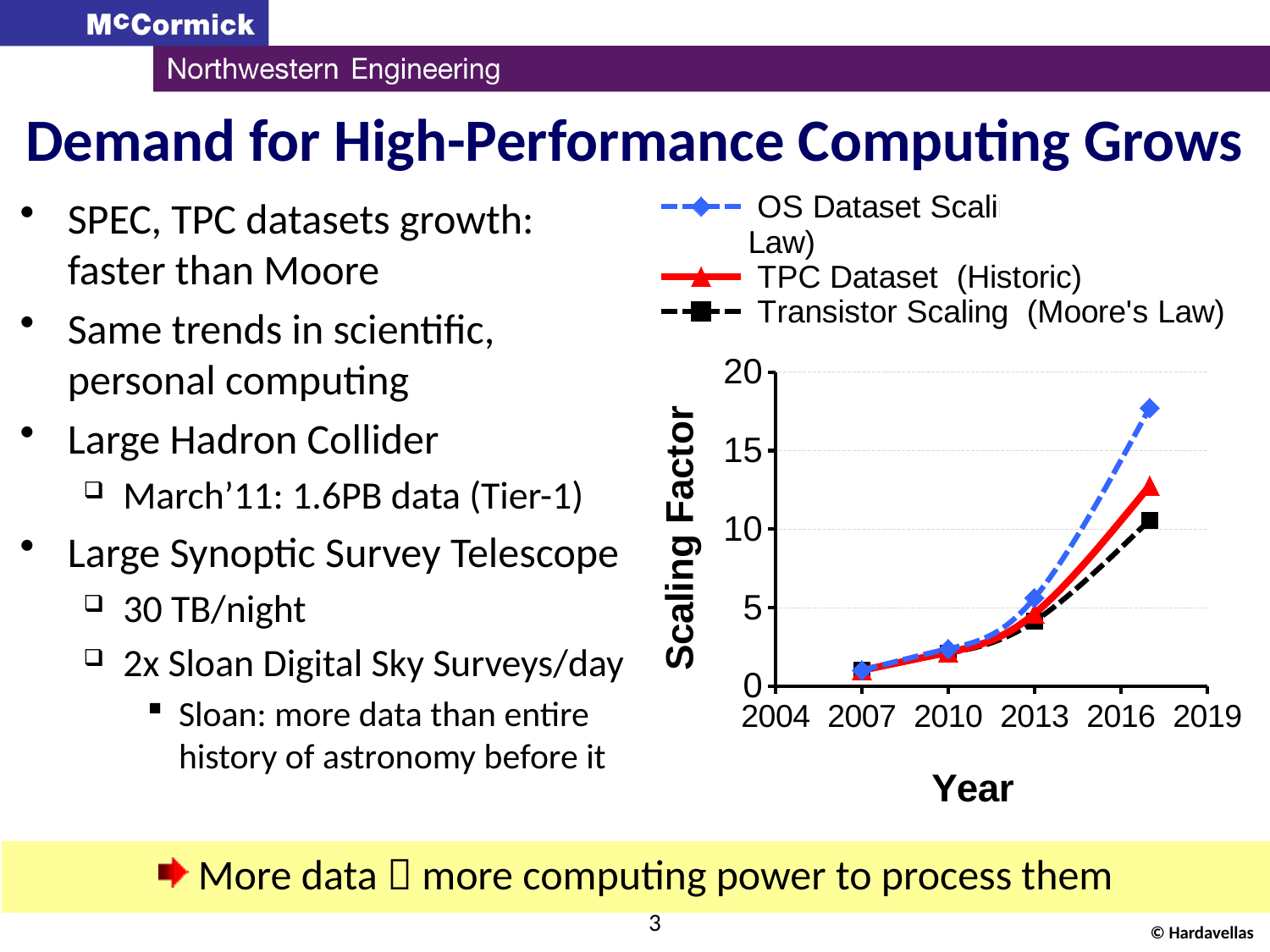
Is the value of the Transistor Scaling (Moore's Law) series at its last point (around 2017) greater or less than 15? less At the last plotted year (around 2017), which is larger: the TPC Dataset (Historic) value or the Transistor Scaling (Moore's Law) value? TPC Dataset (Historic) Is the value of the Transistor Scaling (Moore's Law) series in 2013 greater or less than 5? less How many data points are plotted for the TPC Dataset (Historic) series? 4 Do the values of the TPC Dataset (Historic) series rise or fall as the year increases? rise Which series has the highest value at the last plotted year (around 2017)? OS Dataset Scaling What is the title of the chart's vertical axis? Scaling Factor Is the value of the OS Dataset Scaling series at its last point (around 2017) greater or less than 15? greater What kind of chart is shown on the slide? line chart Which series has the lowest value at the last plotted year (around 2017)? Transistor Scaling (Moore's Law) How many series does the chart's legend list? 3